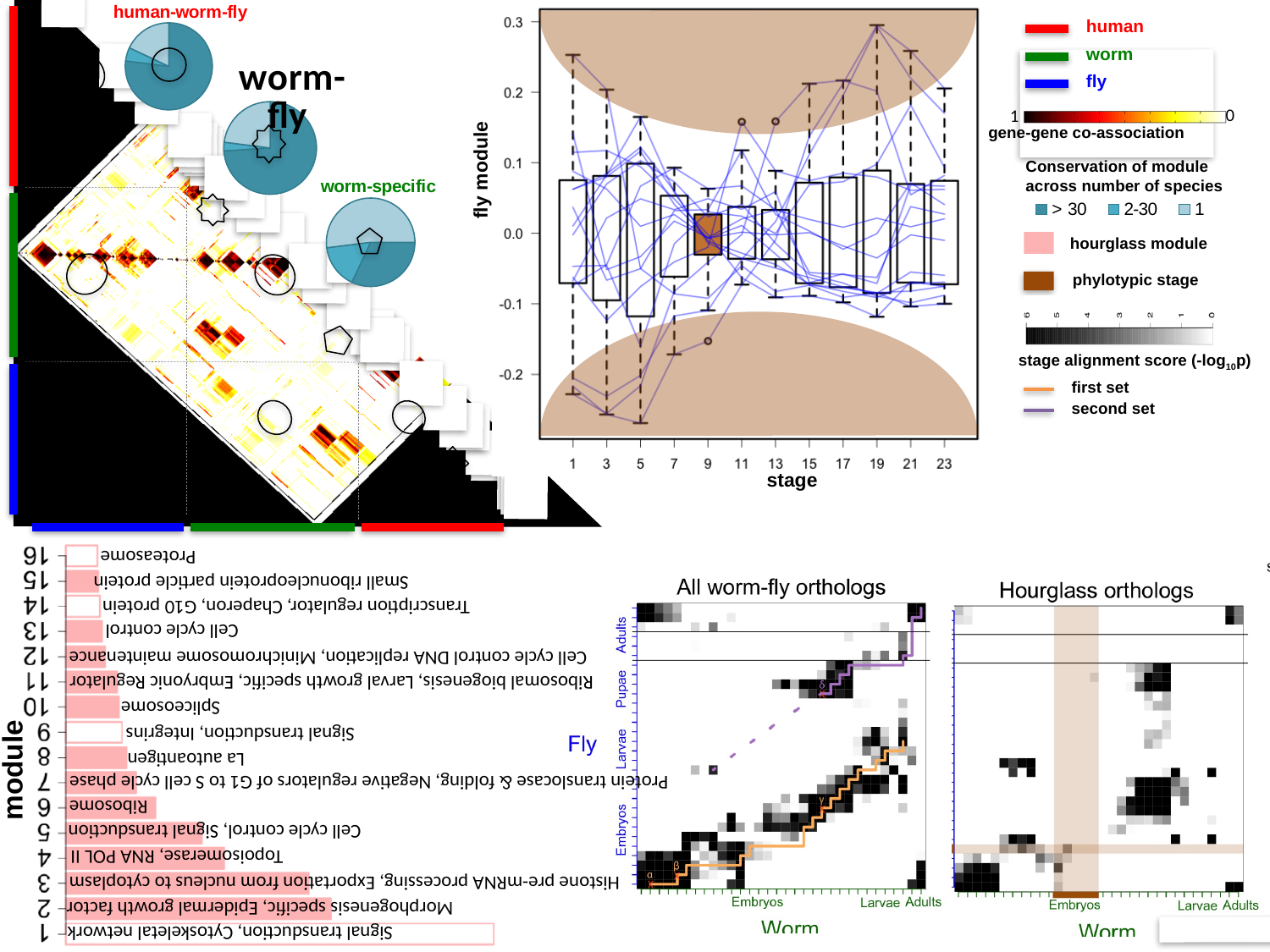
In the 'fly module' box plot, at which stage is the brown phylotypic-stage box drawn? 9 What are the titles of the two heatmaps at the bottom right of the slide? All worm-fly orthologs; Hourglass orthologs In the bottom-left module bar chart, which module has the longest bar? 1 (Signal transduction, Cytoskeletal network) What kind of chart is the top-middle chart with 'fly module' on the y axis and 'stage' on the x axis? box plot In the bottom-left module bar chart, what is the label of module 10? Spliceosome In the 'fly module' box plot, what is the highest value labelled on the y axis? 0.3 In the top-right legend, how many species are listed with coloured bars? 3 In the bottom-left module bar chart, what is the label of module 16? Proteasome In the bottom-left module bar chart, how many modules are listed? 16 In the bottom-left module bar chart, which bar is longer: module 1 or module 6 (Ribosome)? module 1 In the 'fly module' box plot, how many stage ticks are labelled on the x axis? 12 What kind of chart is the bottom-left chart listing modules 1 to 16? bar chart